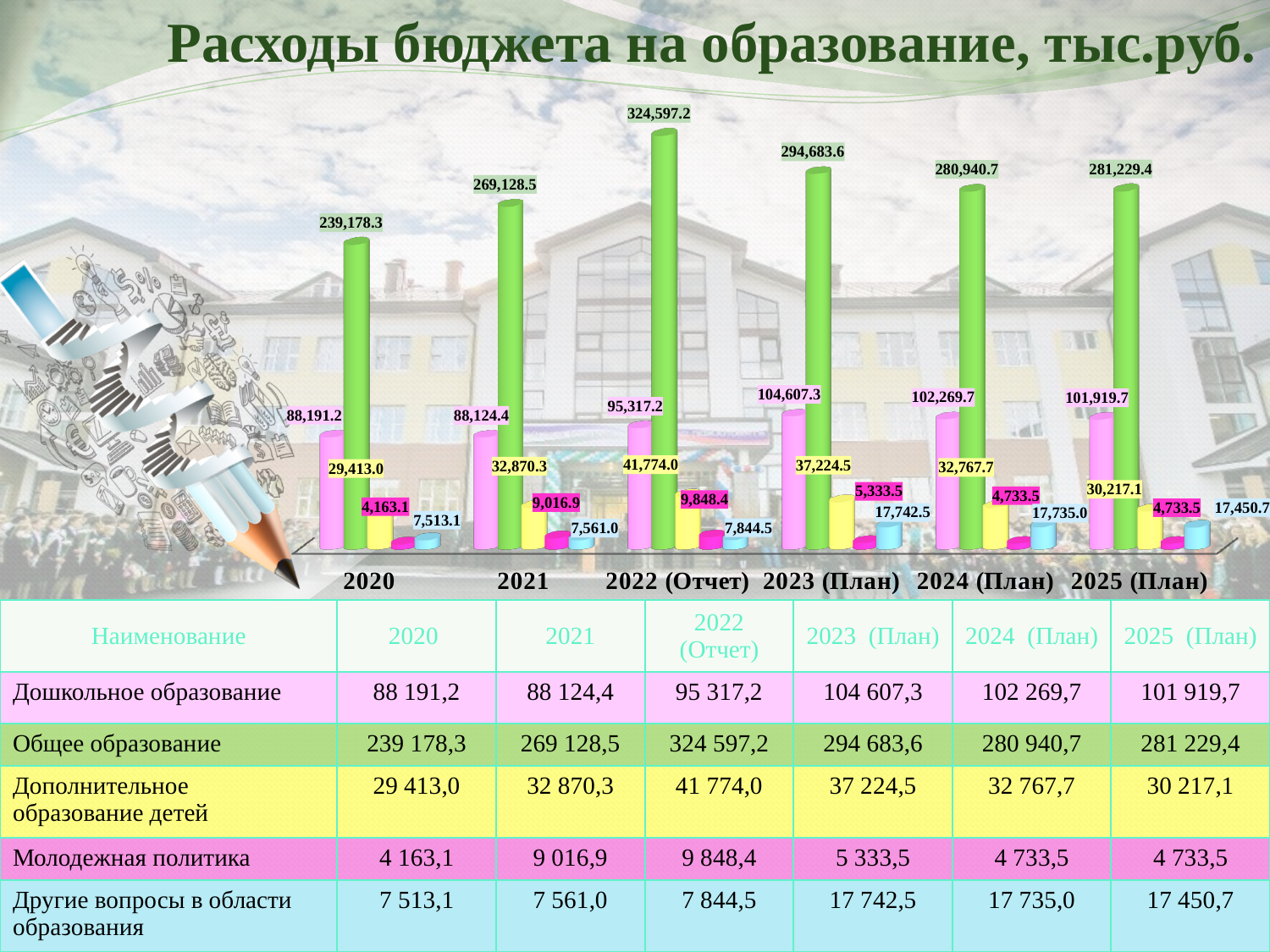
How many year categories are shown on the x axis? 6 What is the value of the green bar for 2022 (Отчет)? 324,597.2 How many bars are plotted for each year? 5 Which is larger, the pink bar for 2023 (План) or the pink bar for 2024 (План)? 2023 (План) Do the green bar values rise or fall from 2020 to 2022 (Отчет)? rise What kind of chart is shown on the slide? bar chart In which year is the green bar the highest? 2022 (Отчет) What is the value of the magenta bar for 2021? 9,016.9 What is the value of the light blue bar for 2025 (План)? 17,450.7 What is the difference between the green bar values for 2022 (Отчет) and 2021? 55,468.7 What is the value of the yellow bar for 2022 (Отчет)? 41,774.0 In which year is the green bar the lowest? 2020